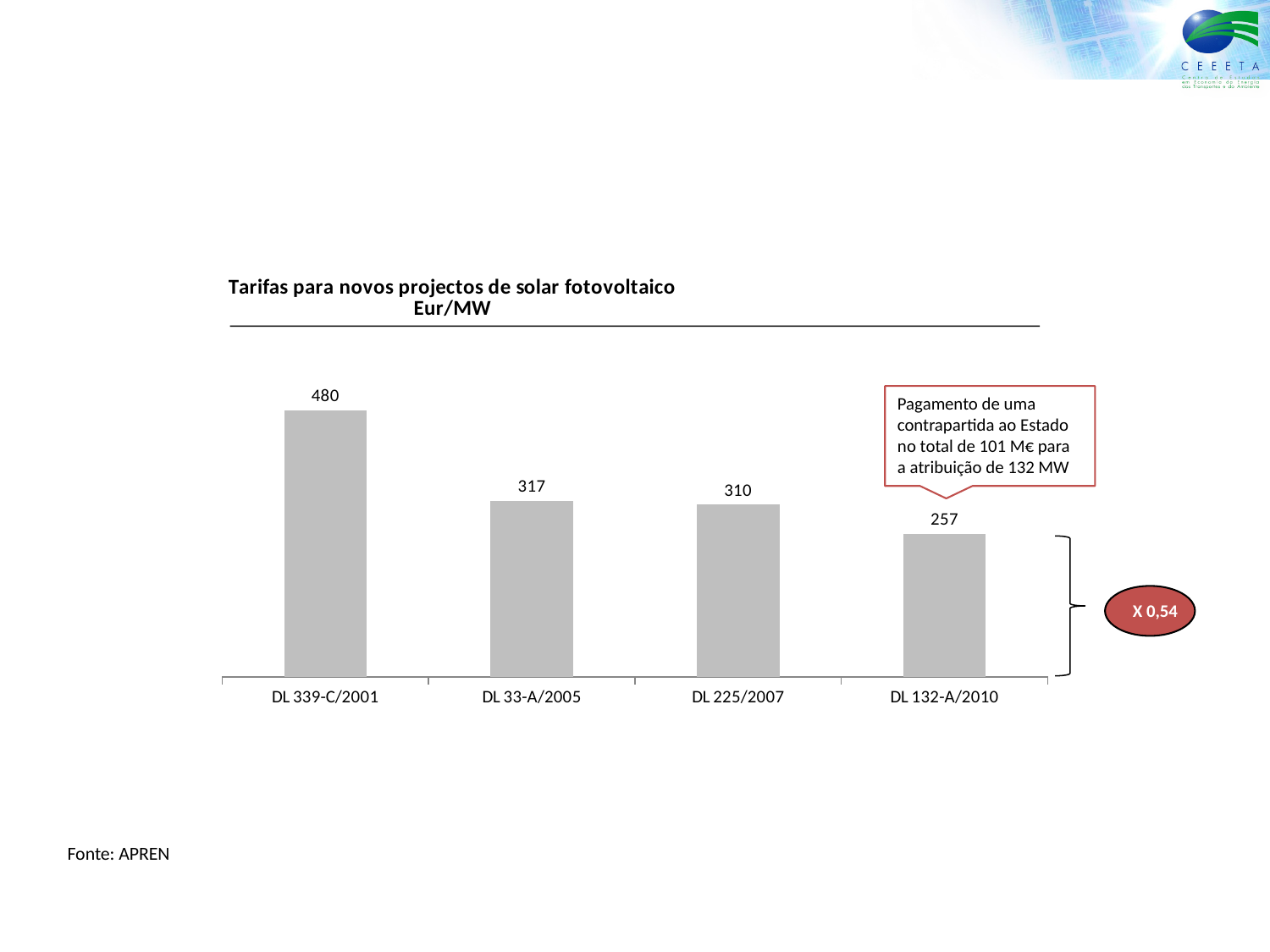
Which category has the highest value? DL 339-C/2001 What is the value for DL 339-C/2001? 480 What is the difference between the values for DL 33-A/2005 and DL 225/2007? 7 How many categories are shown on the x axis? 4 What is the difference between the values for DL 339-C/2001 and DL 132-A/2010? 223 What is the value for DL 33-A/2005? 317 Which is larger, the value for DL 339-C/2001 or the value for DL 33-A/2005? DL 339-C/2001 What is the value for DL 132-A/2010? 257 Which category has the lowest value? DL 132-A/2010 Do the values rise or fall from left to right along the x axis? Fall What is the value for DL 225/2007? 310 What kind of chart is shown on the slide? Bar chart